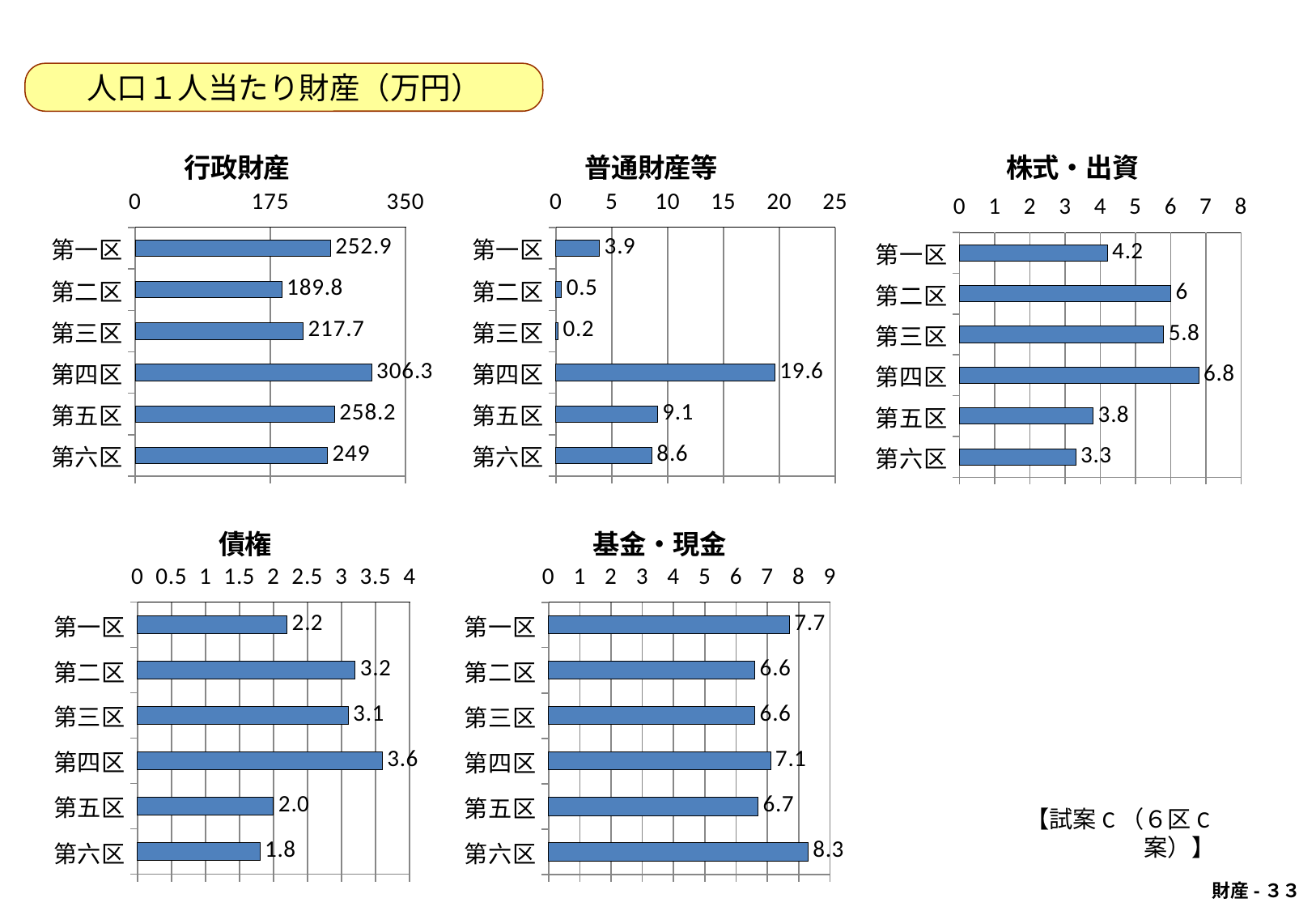
In the 債権 chart, which district has the highest value? 第四区 In the 普通財産等 chart, what is the value for 第四区? 19.6 In the 行政財産 chart, what is the value for 第四区? 306.3 In the 普通財産等 chart, which district has the lowest value? 第三区 In the 株式・出資 chart, which is larger, 第二区 or 第三区? 第二区 In the 株式・出資 chart, what is the difference between 第四区 and 第六区? 3.5 What type of chart is the 債権 chart? Bar chart In the 行政財産 chart, which district has the lowest value? 第二区 In the 基金・現金 chart, what is the difference between 第一区 and 第二区? 1.1 In the 債権 chart, what is the value for 第五区? 2.0 How many districts are shown in the 行政財産 chart? 6 In the 基金・現金 chart, what is the value for 第六区? 8.3